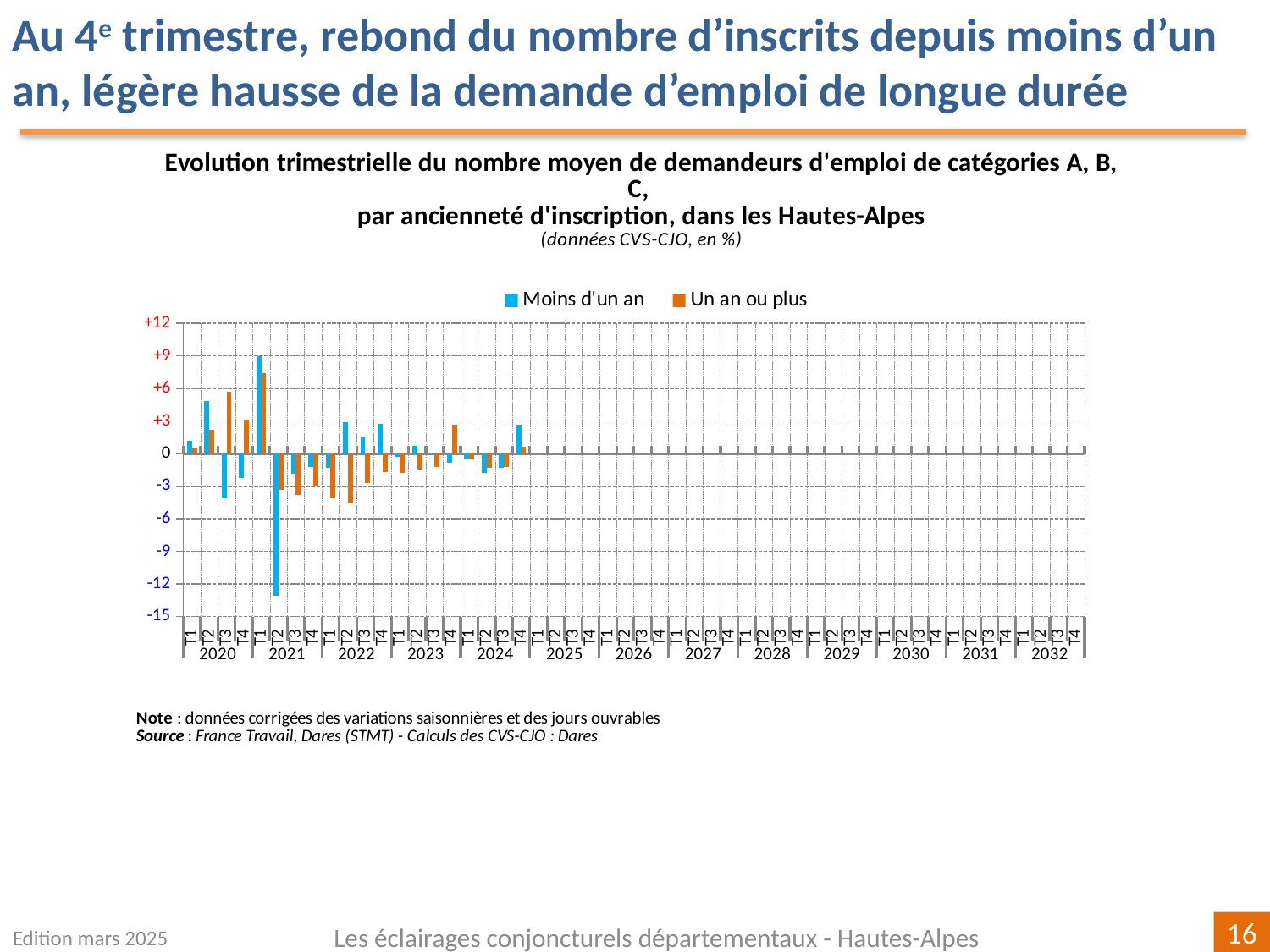
Is the value for 'Moins d'un an' in T2 2020 greater or less than +3? greater In which quarter does the 'Un an ou plus' series reach its highest value? T1 2021 In which quarter does the 'Moins d'un an' series reach its lowest value? T2 2021 Is the value for 'Moins d'un an' in T2 2021 greater or less than -12? less Which colour represents the series 'Un an ou plus'? orange In which quarter does the 'Moins d'un an' series reach its highest value? T1 2021 What kind of chart is shown on the slide? bar chart Is the value for 'Un an ou plus' in T1 2021 greater or less than +6? greater How many years are labelled along the x axis? 13 In T2 2021, which series has the larger value, 'Moins d'un an' or 'Un an ou plus'? Un an ou plus What are the two series named in the legend? Moins d'un an; Un an ou plus How many series does the legend list? 2